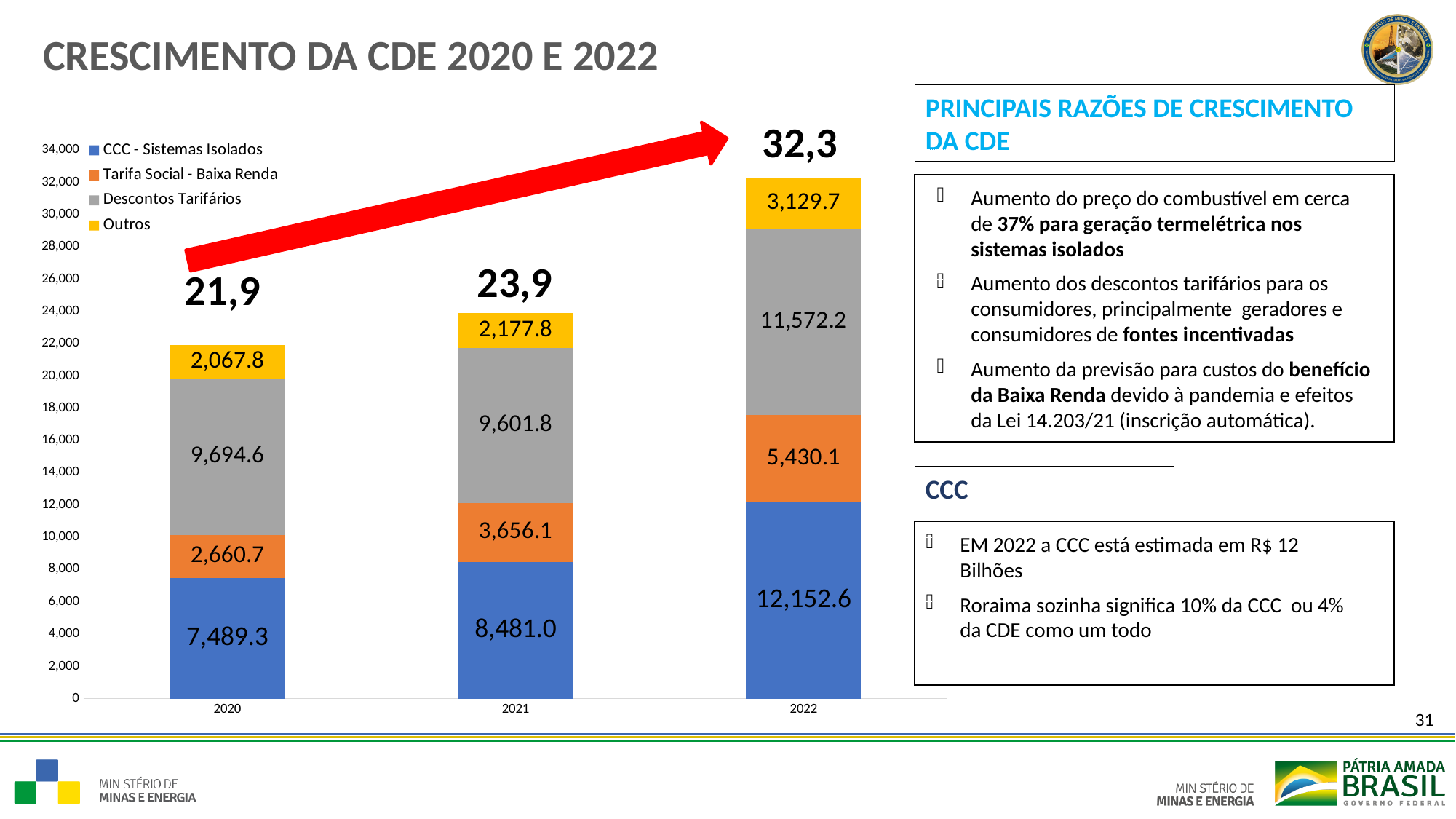
What is the value of Descontos Tarifários for 2020? 9,694.6 Which year has the lowest value for CCC - Sistemas Isolados? 2020 What is the value of CCC - Sistemas Isolados for 2022? 12,152.6 Which year has the highest value for Outros? 2022 How many years are shown on the x axis? 3 What is the difference between the Descontos Tarifários values for 2022 and 2021? 1,970.4 What total is printed above the 2022 bar? 32,3 How many series does the legend list? 4 What kind of chart is shown on the slide? Stacked bar chart What is the value of Tarifa Social - Baixa Renda for 2021? 3,656.1 Which is larger, Descontos Tarifários in 2020 or in 2021? 2020 What is the difference between the CCC - Sistemas Isolados values for 2022 and 2020? 4,663.3